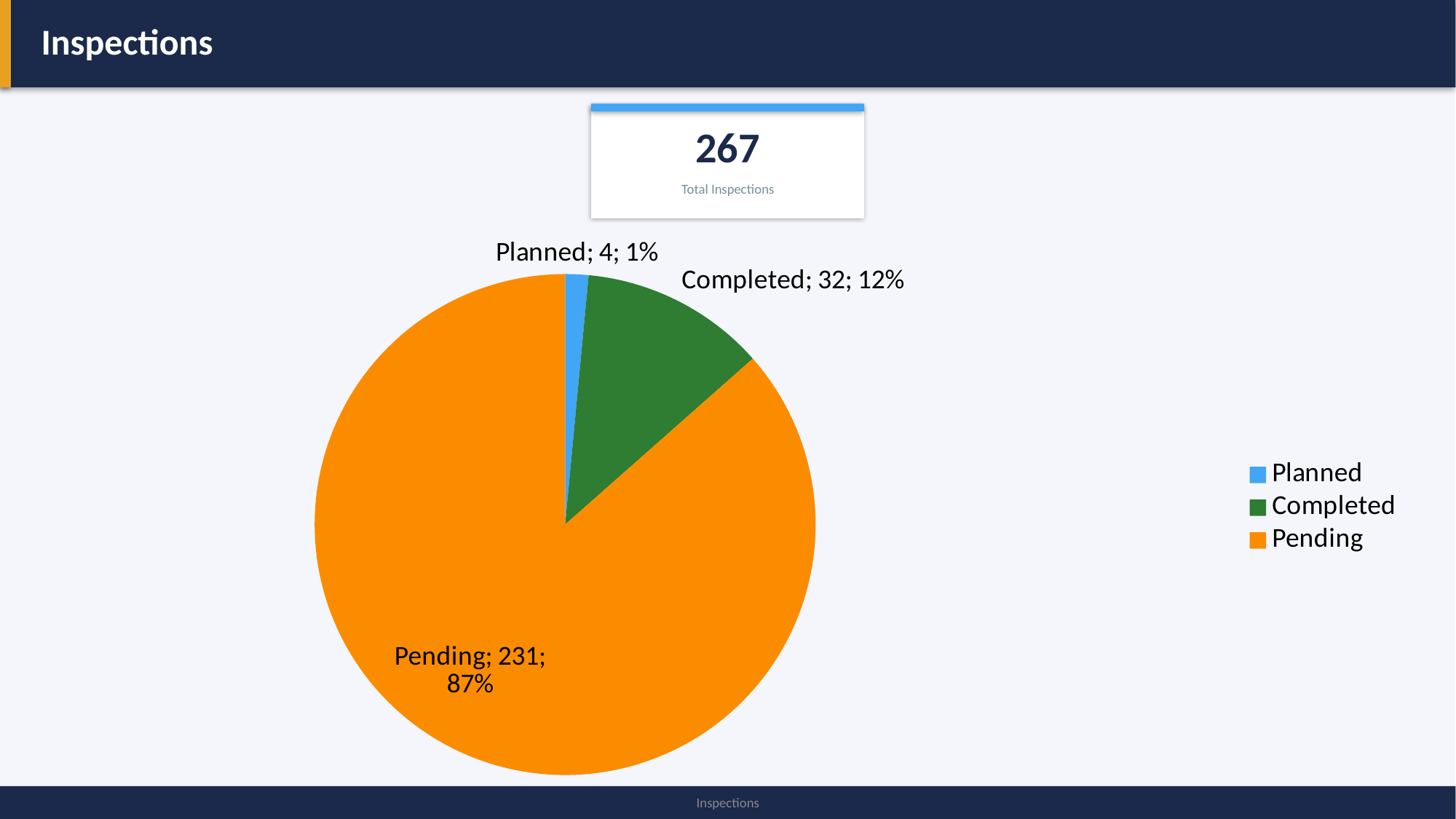
Which category has the smallest slice of the pie chart? Planned How many inspections are Completed according to the pie chart? 32 How many inspections are Pending according to the pie chart? 231 How many inspections are Planned according to the pie chart? 4 What share of the pie does the Pending slice represent? 87% What share of the pie does the Completed slice represent? 12% What colour is the Pending slice in the pie chart? orange How many categories does the pie chart have? 3 What kind of chart is shown on the slide? pie chart What is the difference between the Pending and Completed values? 199 Which is larger, the Completed value or the Planned value? Completed Which category has the largest slice of the pie chart? Pending